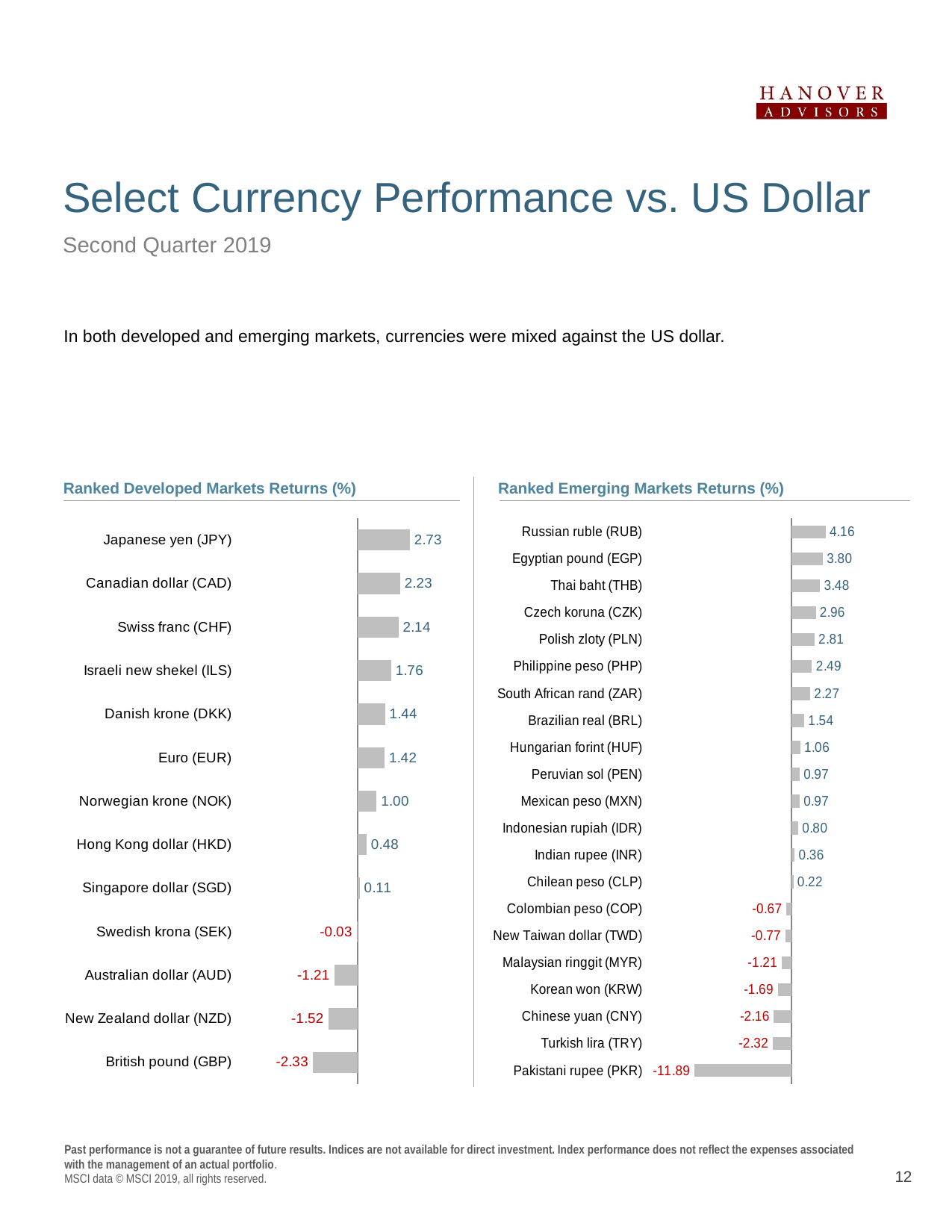
In the Ranked Developed Markets Returns (%) chart, which is larger, the value for the Euro (EUR) or the Norwegian krone (NOK)? Euro (EUR) In the Ranked Emerging Markets Returns (%) chart, what is the difference between the Egyptian pound (EGP) and the Thai baht (THB) values? 0.32 In the Ranked Developed Markets Returns (%) chart, what is the value for the Japanese yen (JPY)? 2.73 In the Ranked Emerging Markets Returns (%) chart, what is the value for the Turkish lira (TRY)? -2.32 In the Ranked Emerging Markets Returns (%) chart, which currency has the highest return? Russian ruble (RUB) What kind of chart is the Ranked Developed Markets Returns (%) chart? Bar chart In the Ranked Developed Markets Returns (%) chart, what is the difference between the Canadian dollar (CAD) and the Swiss franc (CHF) values? 0.09 In the Ranked Developed Markets Returns (%) chart, which currency has the lowest return? British pound (GBP) How many currencies are shown in the Ranked Emerging Markets Returns (%) chart? 21 In the Ranked Emerging Markets Returns (%) chart, which currency has the lowest return? Pakistani rupee (PKR) How many currencies are shown in the Ranked Developed Markets Returns (%) chart? 13 In the Ranked Emerging Markets Returns (%) chart, which is larger, the value for the Chinese yuan (CNY) or the Korean won (KRW)? Korean won (KRW)